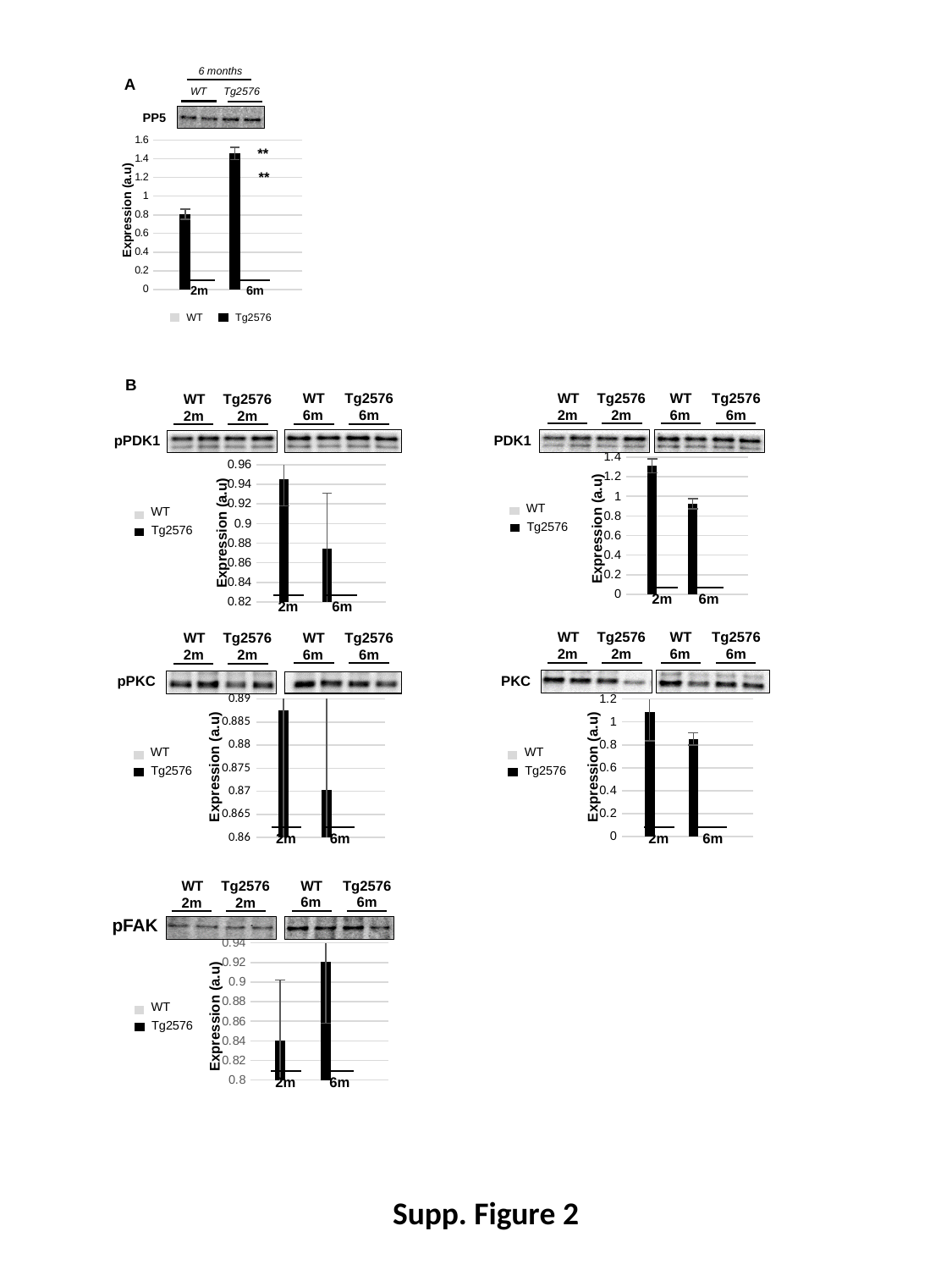
In the pFAK chart, do the Tg2576 values rise or fall from 2m to 6m? rise In the pPDK1 chart, is the Tg2576 value at 6m greater or less than 0.9? less What kind of chart is the PDK1 chart in panel B? bar chart How many categories are shown on the x axis of the pPKC chart? 2 In the PKC chart, is the Tg2576 value at 6m greater or less than 1? less In the PP5 chart (panel A), is the Tg2576 value at 2m greater or less than 1? less In the PDK1 chart, do the Tg2576 values rise or fall from 2m to 6m? fall In the PP5 chart (panel A), which Tg2576 bar is taller, 2m or 6m? 6m How many series does the legend of the PP5 chart (panel A) list? 2